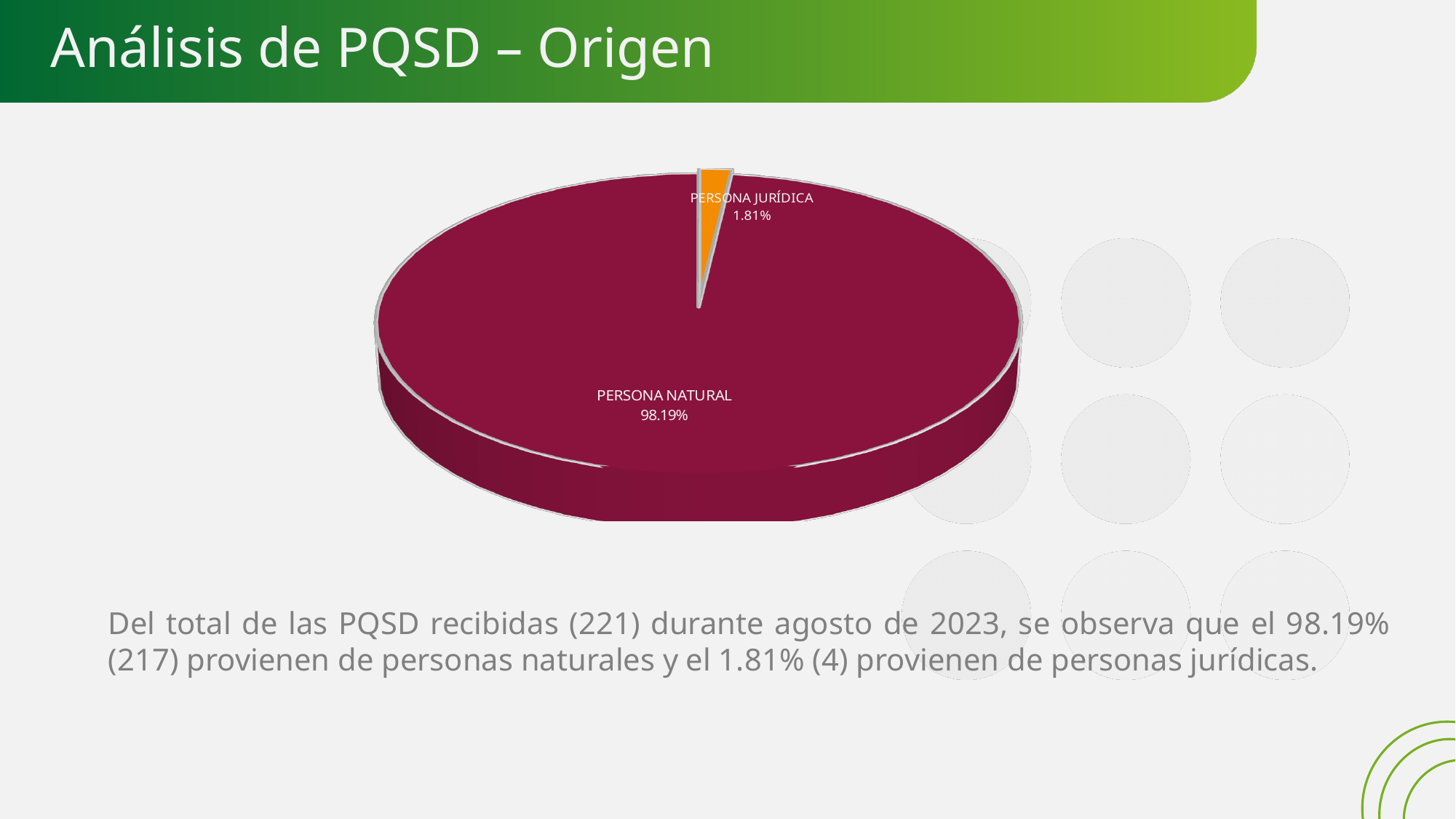
What kind of chart is shown on the slide? Pie chart What share of the pie does PERSONA NATURAL represent? 98.19% What colour is the PERSONA JURÍDICA slice? Orange What share of the pie does PERSONA JURÍDICA represent? 1.81% Which slice is larger, PERSONA NATURAL or PERSONA JURÍDICA? PERSONA NATURAL Which category has the smallest slice of the pie? PERSONA JURÍDICA What is the difference in percentage points between the PERSONA NATURAL and PERSONA JURÍDICA slices? 96.38% What colour is the PERSONA NATURAL slice? Dark magenta How many categories are shown in the pie chart? 2 Which category has the largest slice of the pie? PERSONA NATURAL